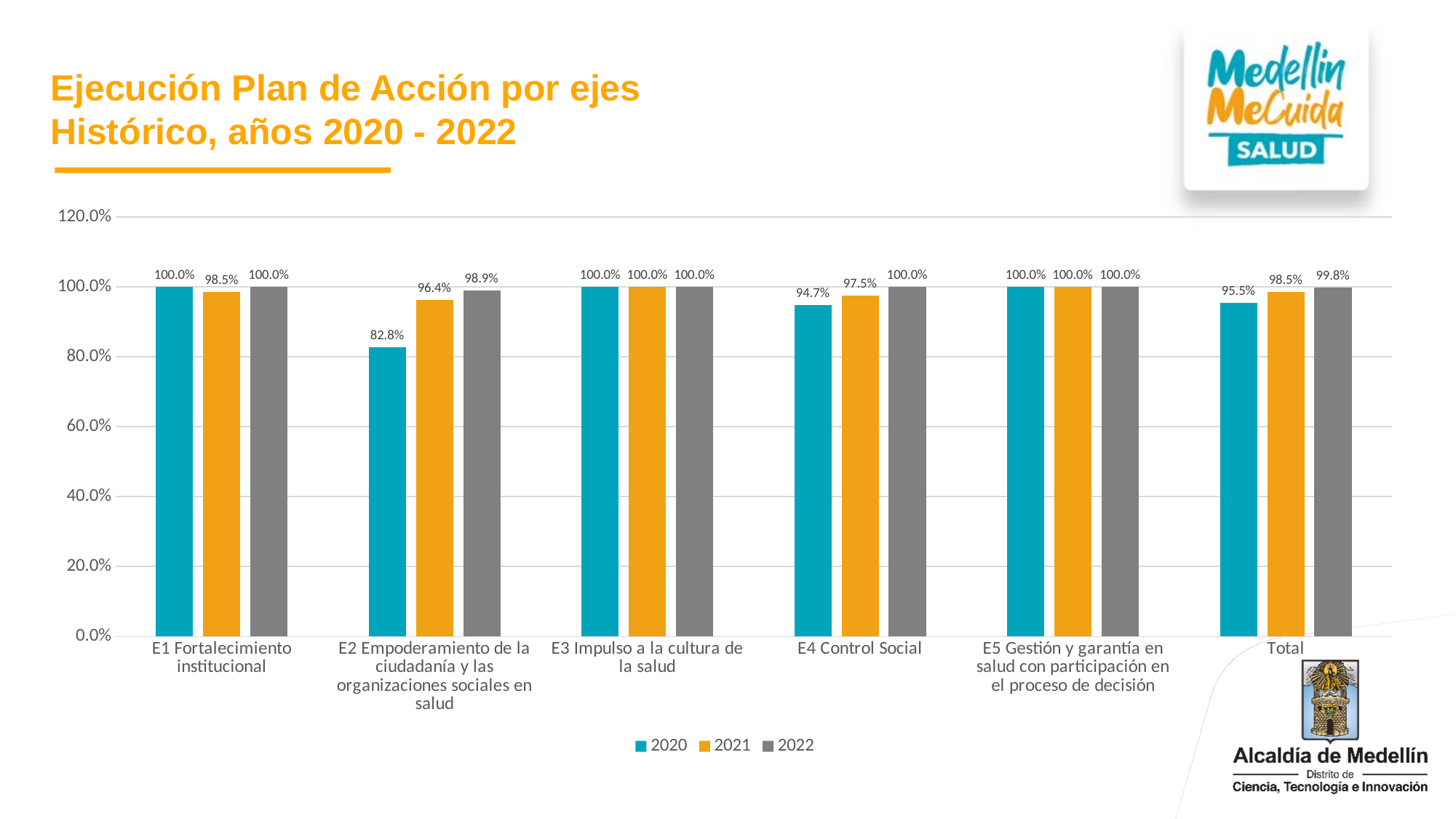
Is the 2020 value for E2 Empoderamiento de la ciudadanía y las organizaciones sociales en salud greater or less than 100.0%? less What is the 2021 value for E4 Control Social? 97.5% Which is larger for E4 Control Social, the 2020 value or the 2021 value? 2021 How many series does the legend list? 3 Which category has the lowest 2021 value? E2 Empoderamiento de la ciudadanía y las organizaciones sociales en salud What is the 2020 value for E2 Empoderamiento de la ciudadanía y las organizaciones sociales en salud? 82.8% How many categories are shown on the x axis? 6 What is the 2022 value for Total? 99.8% Which category has the lowest 2020 value? E2 Empoderamiento de la ciudadanía y las organizaciones sociales en salud What kind of chart is shown on the slide? bar chart What is the difference between the 2022 and 2020 values for E2 Empoderamiento de la ciudadanía y las organizaciones sociales en salud? 16.1% What is the 2020 value for E4 Control Social? 94.7%